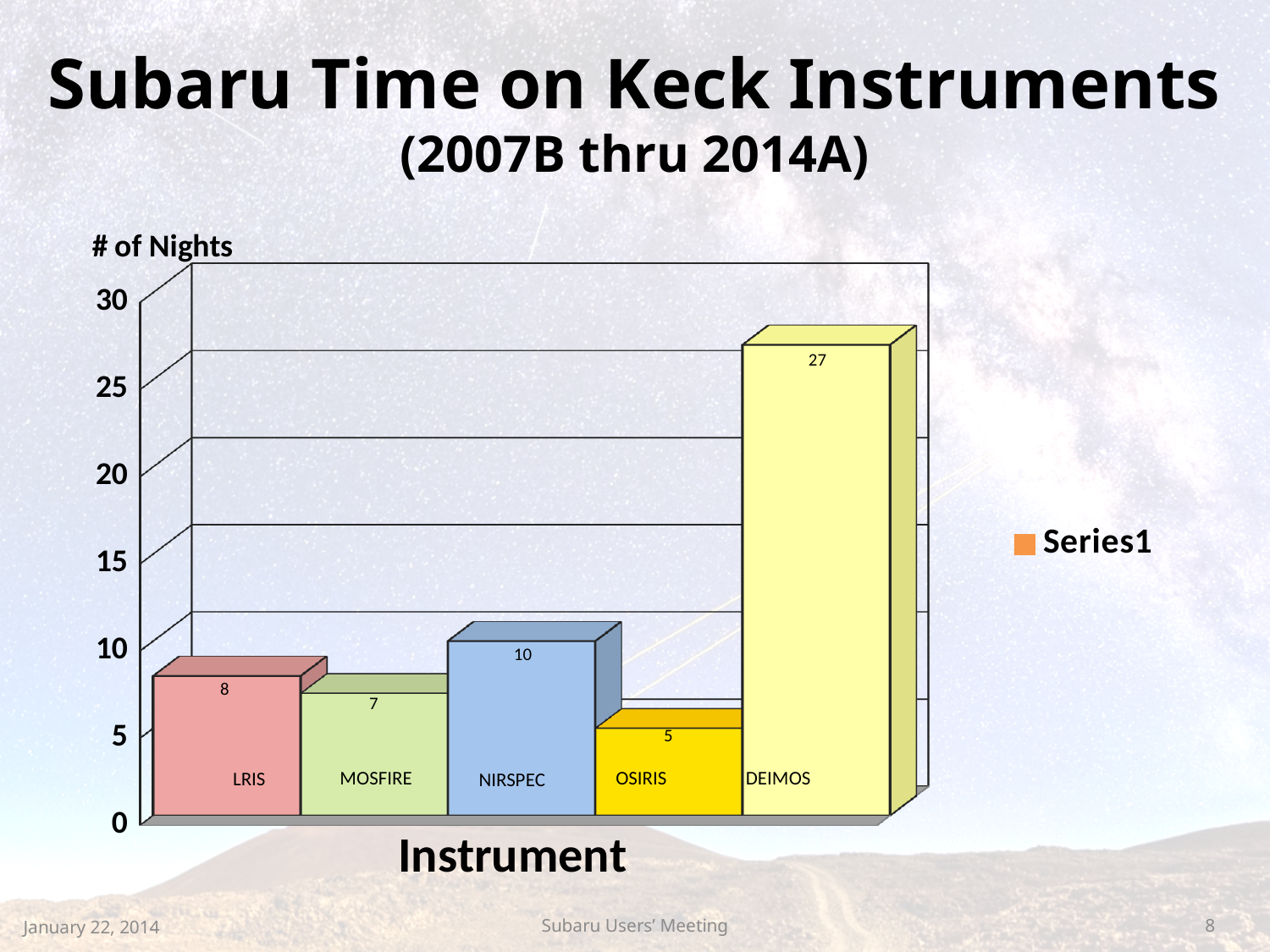
What is the number of nights for OSIRIS? 5 What type of chart is shown on the slide? bar chart What is the difference in nights between LRIS and MOSFIRE? 1 Which instrument has the lowest number of nights? OSIRIS What is the difference in nights between DEIMOS and NIRSPEC? 17 How many instruments are shown on the x axis? 5 What is the label of the vertical axis? # of Nights How many nights does the chart show for DEIMOS? 27 What is the number of nights for NIRSPEC? 10 Which instrument has the highest number of nights? DEIMOS Which has more nights, LRIS or OSIRIS? LRIS Is the value for DEIMOS greater or less than 25? greater